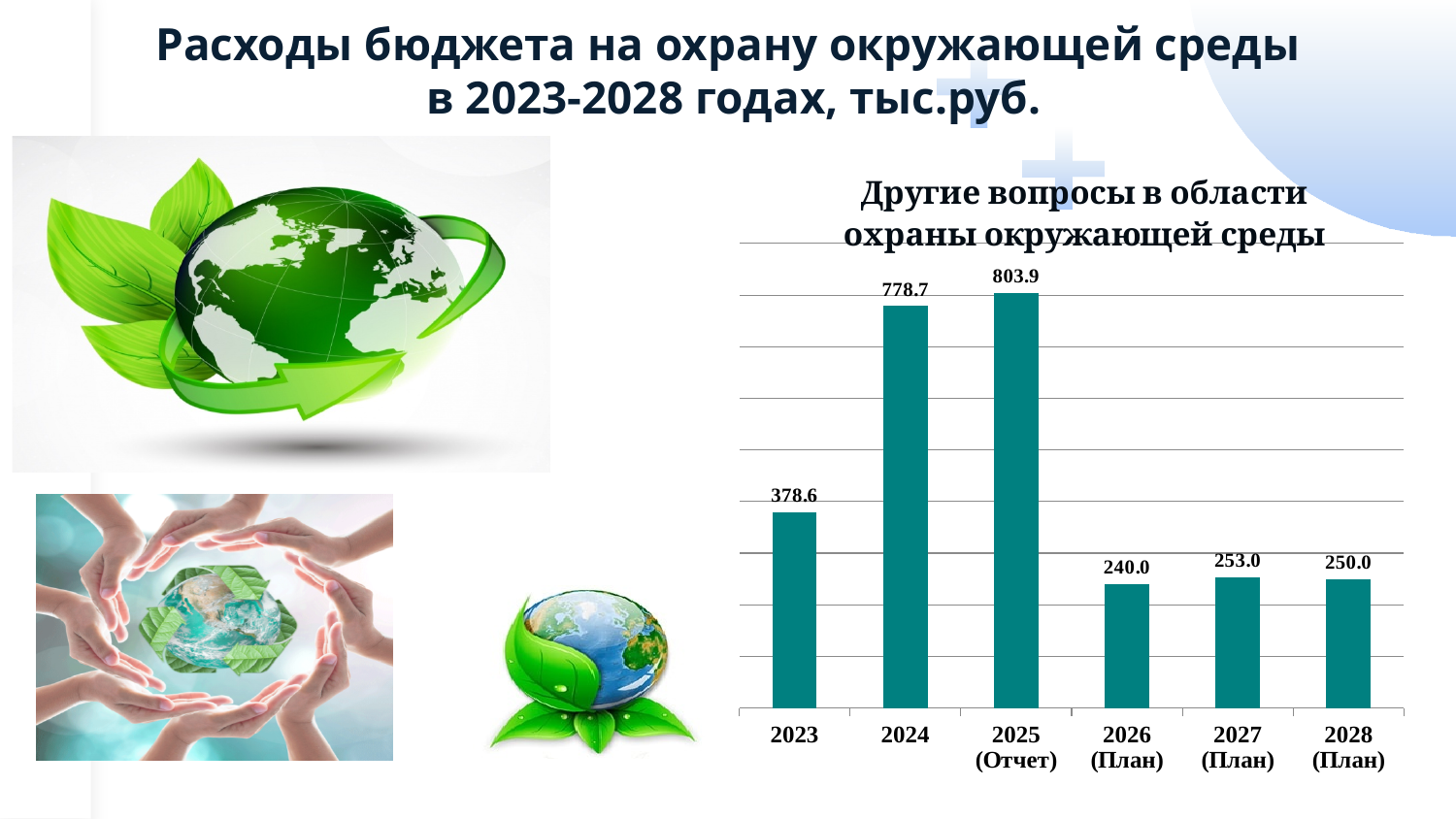
What is the value for 2023? 378.6 Which year has the lowest value? 2026 (План) Which year has the highest value? 2025 (Отчет) What is the difference between the values for 2024 and 2023? 400.1 What is the value for 2028 (План)? 250.0 What is the difference between the values for 2025 (Отчет) and 2024? 25.2 What is the title of the chart? Другие вопросы в области охраны окружающей среды How many years are shown on the x axis? 6 What kind of chart is this? bar chart What is the value for 2025 (Отчет)? 803.9 What is the value for 2027 (План)? 253.0 Which is larger, the value for 2027 (План) or the value for 2026 (План)? 2027 (План)